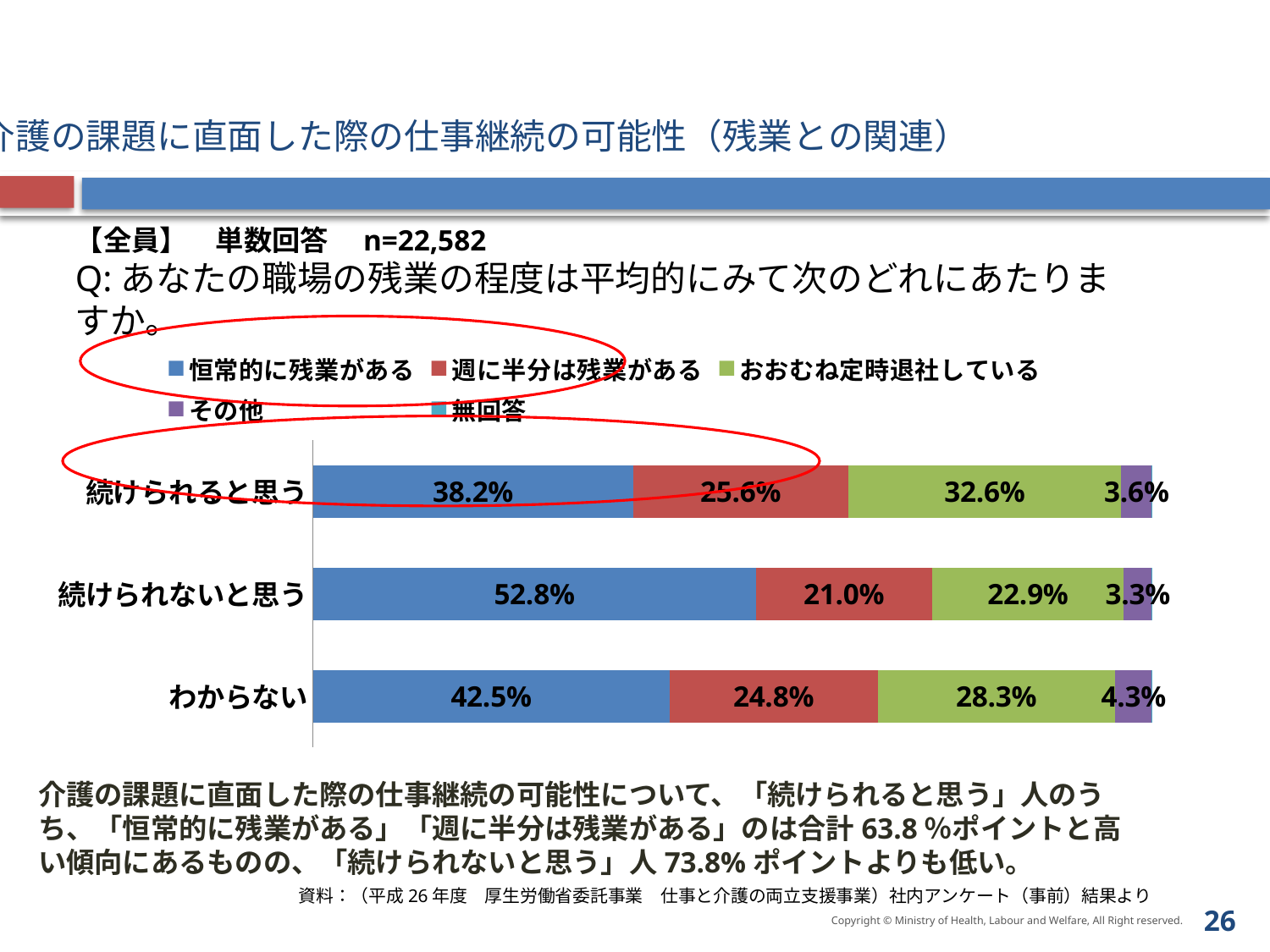
What kind of chart is shown on the slide? stacked bar chart What is the value of 恒常的に残業がある for 続けられると思う? 38.2% What is the difference between the 恒常的に残業がある values for 続けられないと思う and 続けられると思う? 14.6% What is the value of 週に半分は残業がある for 続けられないと思う? 21.0% Which legend entry is shown in green? おおむね定時退社している Which category has the lowest value for おおむね定時退社している? 続けられないと思う What is the value of おおむね定時退社している for わからない? 28.3% How many series does the legend list? 5 Which is larger: the 週に半分は残業がある value for 続けられると思う or for わからない? 続けられると思う What is the value of その他 for 続けられないと思う? 3.3% Which category has the highest value for 恒常的に残業がある? 続けられないと思う How many categories (bars) are plotted in the chart? 3